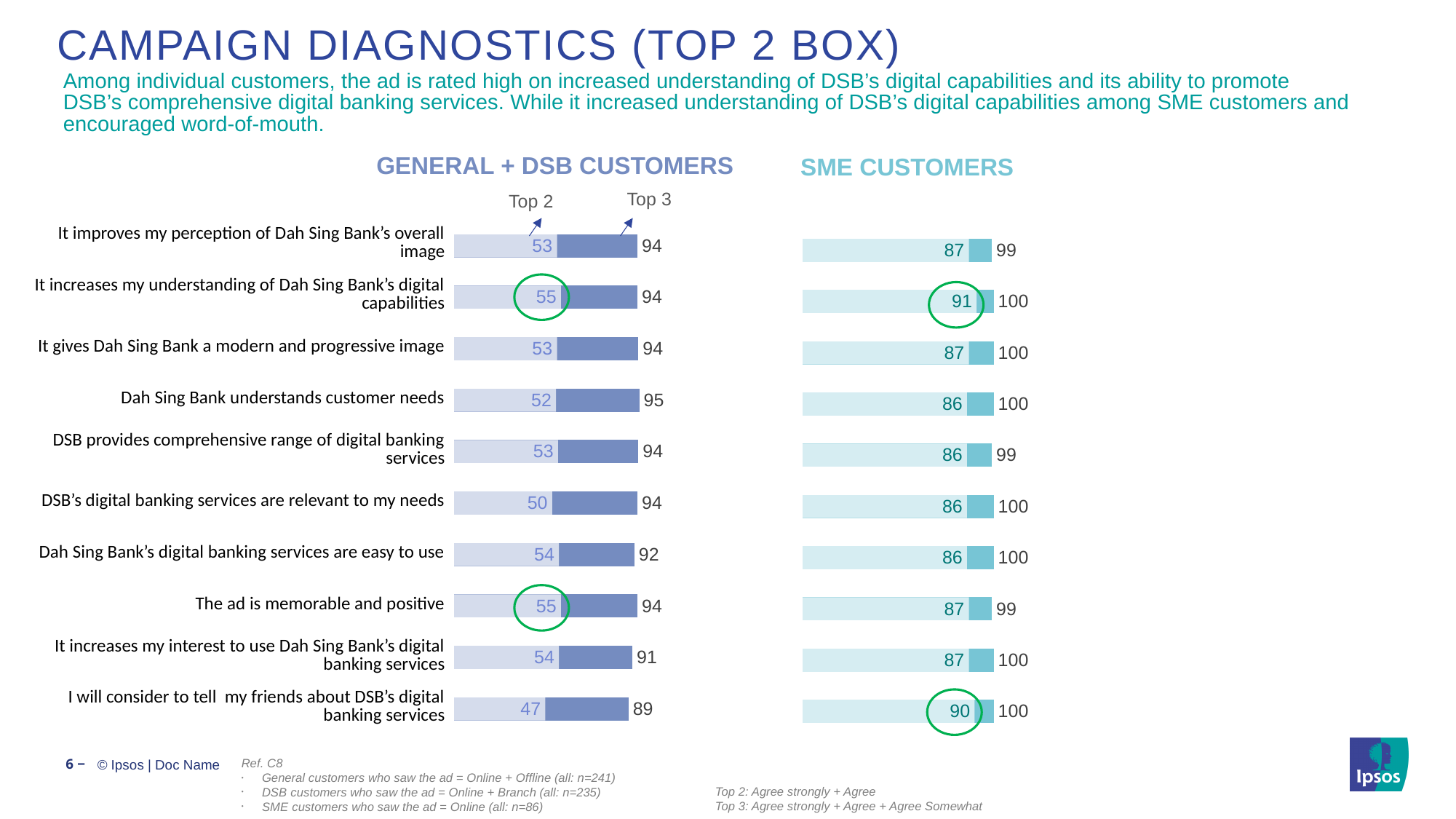
On the GENERAL + DSB CUSTOMERS chart, what is the Top 3 value for "Dah Sing Bank understands customer needs"? 95 On the SME CUSTOMERS chart, which statement has the highest Top 2 value? It increases my understanding of Dah Sing Bank's digital capabilities On the SME CUSTOMERS chart, what is the difference between the Top 2 values for "It increases my understanding of Dah Sing Bank's digital capabilities" and "Dah Sing Bank understands customer needs"? 5 What type of chart is used for the GENERAL + DSB CUSTOMERS data? Bar chart On the GENERAL + DSB CUSTOMERS chart, which statement has the lowest Top 2 value? I will consider to tell my friends about DSB's digital banking services On the GENERAL + DSB CUSTOMERS chart, which has the higher Top 2 value: "DSB's digital banking services are relevant to my needs" or "Dah Sing Bank's digital banking services are easy to use"? Dah Sing Bank's digital banking services are easy to use What are the two measures labelled above the bars on the GENERAL + DSB CUSTOMERS chart? Top 2 and Top 3 On the SME CUSTOMERS chart, what is the Top 3 value for "It improves my perception of Dah Sing Bank's overall image"? 99 On the GENERAL + DSB CUSTOMERS chart, what is the difference between the Top 3 and Top 2 values for "I will consider to tell my friends about DSB's digital banking services"? 42 How many statements are plotted on the SME CUSTOMERS chart? 10 On the GENERAL + DSB CUSTOMERS chart, what is the Top 2 value for "It increases my understanding of Dah Sing Bank's digital capabilities"? 55 On the SME CUSTOMERS chart, what is the Top 2 value for "I will consider to tell my friends about DSB's digital banking services"? 90